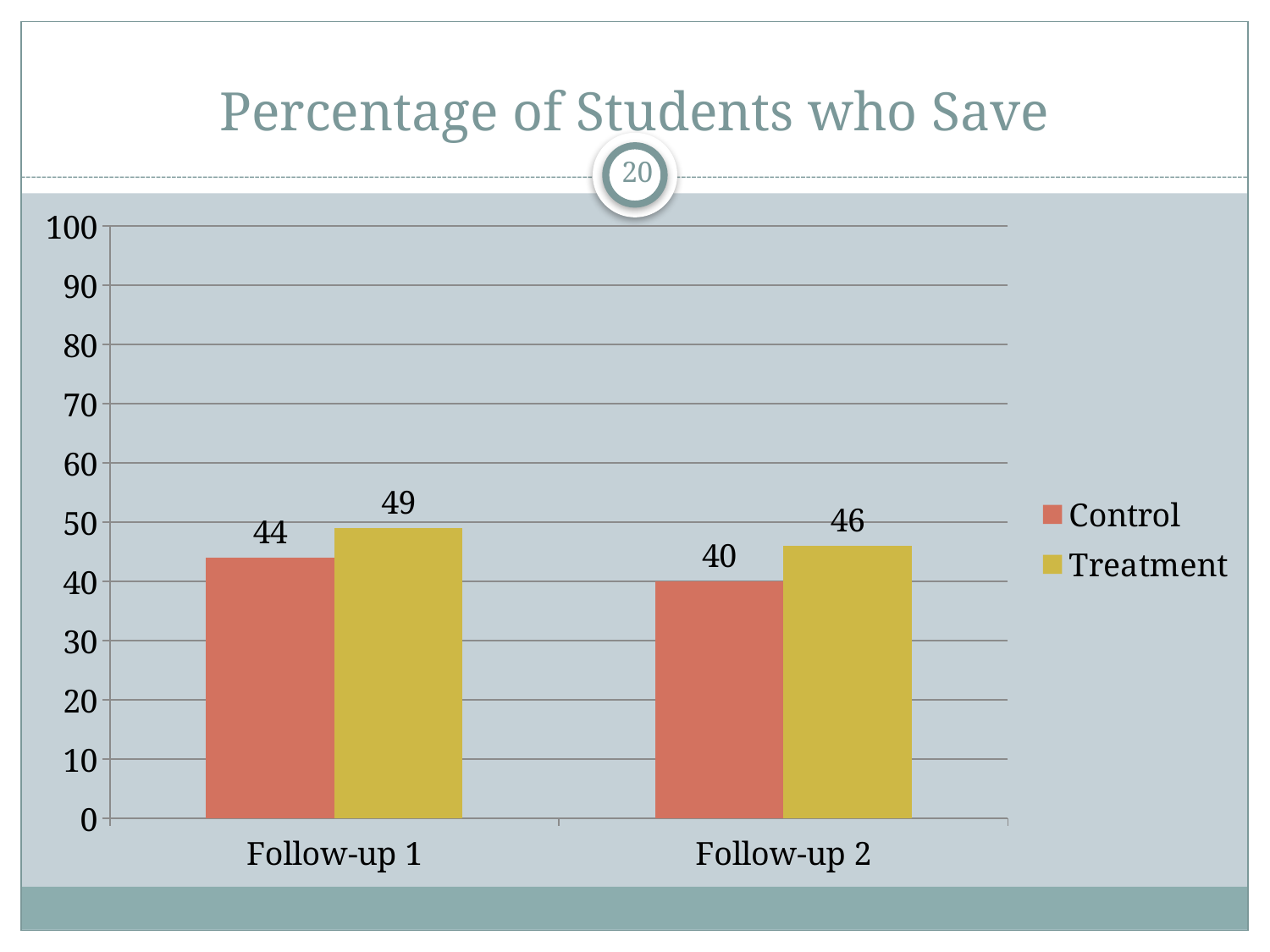
How many categories are shown on the x axis? 2 Which group has the highest value at Follow-up 1? Treatment What kind of chart is shown on the slide? Bar chart What is the value for Treatment at Follow-up 2? 46 How many series does the legend list? 2 Which bar has the lowest value on the chart? Control at Follow-up 2 Is the value for Treatment at Follow-up 1 greater or less than 50? less Which is larger: Control at Follow-up 1 or Treatment at Follow-up 2? Treatment at Follow-up 2 What is the difference between Treatment and Control at Follow-up 2? 6 What is the value for Control at Follow-up 1? 44 What is the value for Treatment at Follow-up 1? 49 What is the value for Control at Follow-up 2? 40